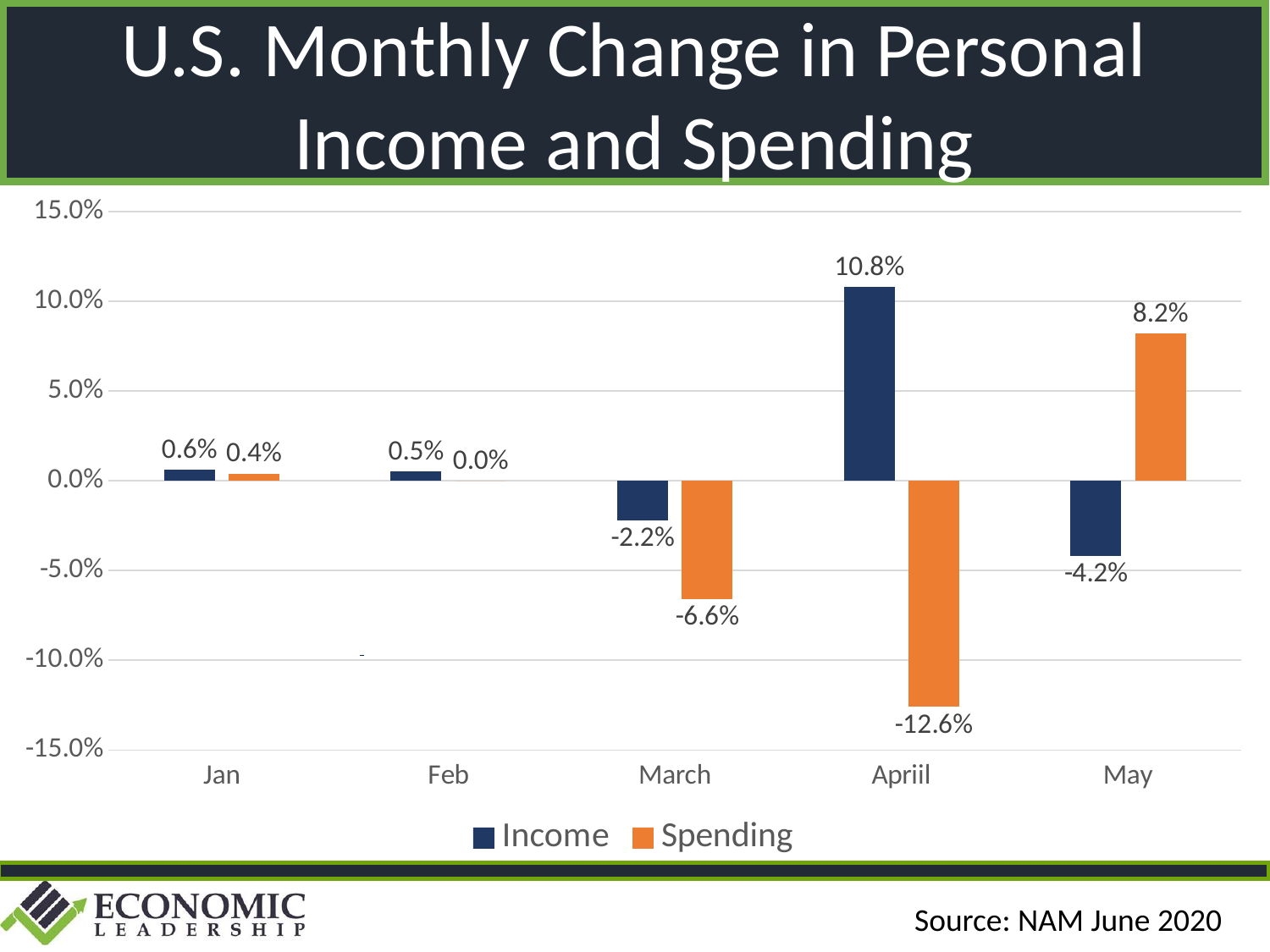
What is the difference between the Income and Spending values for April? 23.4 percentage points What is the Income value for Feb? 0.5% What kind of chart is shown on the slide? Bar chart What is the source cited at the bottom of the slide? NAM June 2020 Which is larger in May, the Income value or the Spending value? Spending How many months are shown on the x axis? 5 What is the Spending value for May? 8.2% What is the Spending value for March? -6.6% Which month has the highest Income value? April What is the Income value for April? 10.8% Which month has the lowest Spending value? April How many series does the legend list? 2